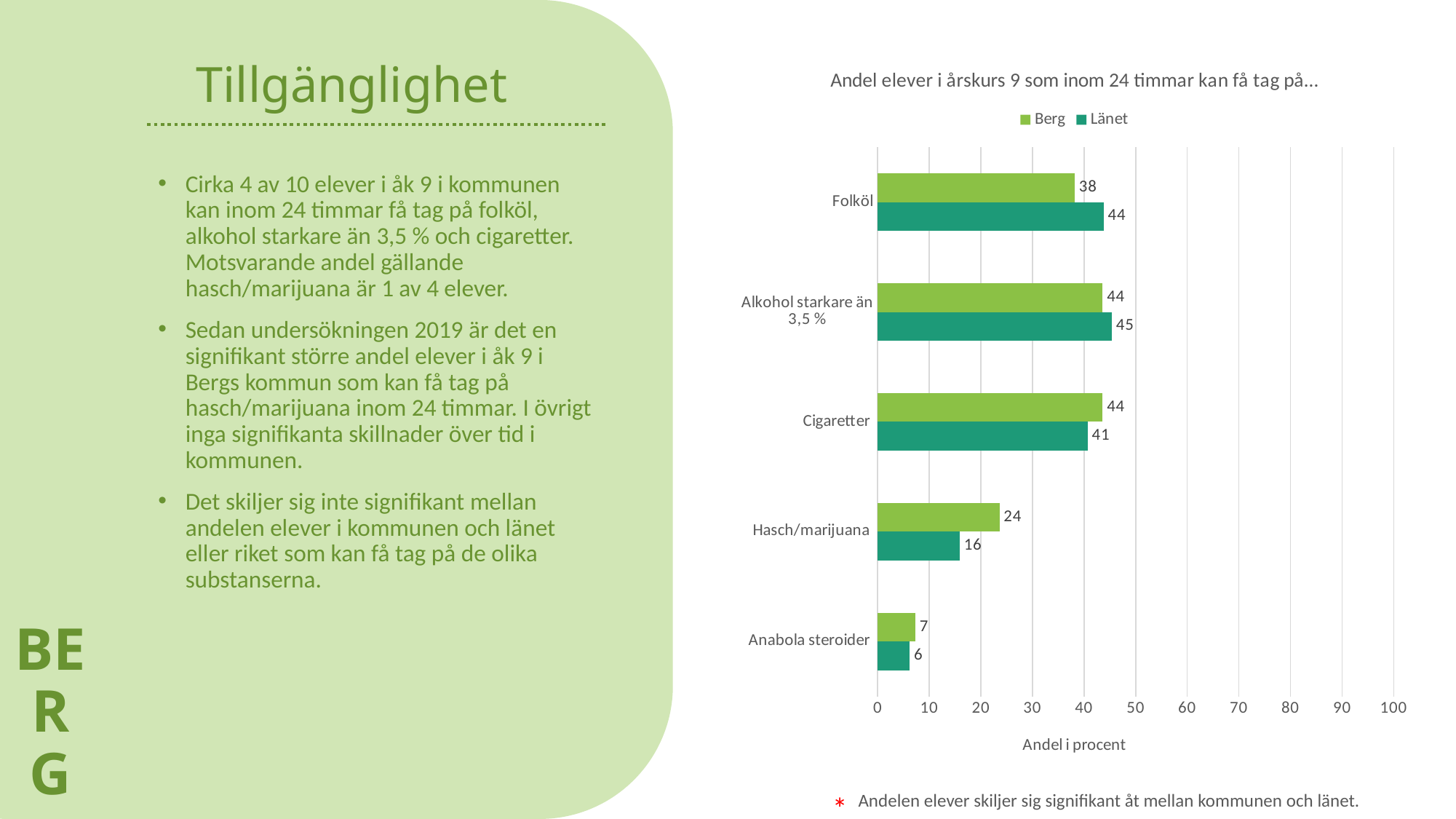
What kind of chart is shown on the slide? Bar chart How many series does the legend list? 2 What is the value for Berg for Folköl? 38 What is the difference between the Berg and Länet values for Hasch/marijuana? 8 Which category has the lowest value for Berg? Anabola steroider How many categories are shown on the chart? 5 Which category has the highest value for Länet? Alkohol starkare än 3,5 % What is the label of the x axis? Andel i procent Which is larger for Cigaretter, the Berg value or the Länet value? Berg What is the value for Berg for Anabola steroider? 7 What is the value for Länet for Hasch/marijuana? 16 What is the difference between the Länet and Berg values for Folköl? 6